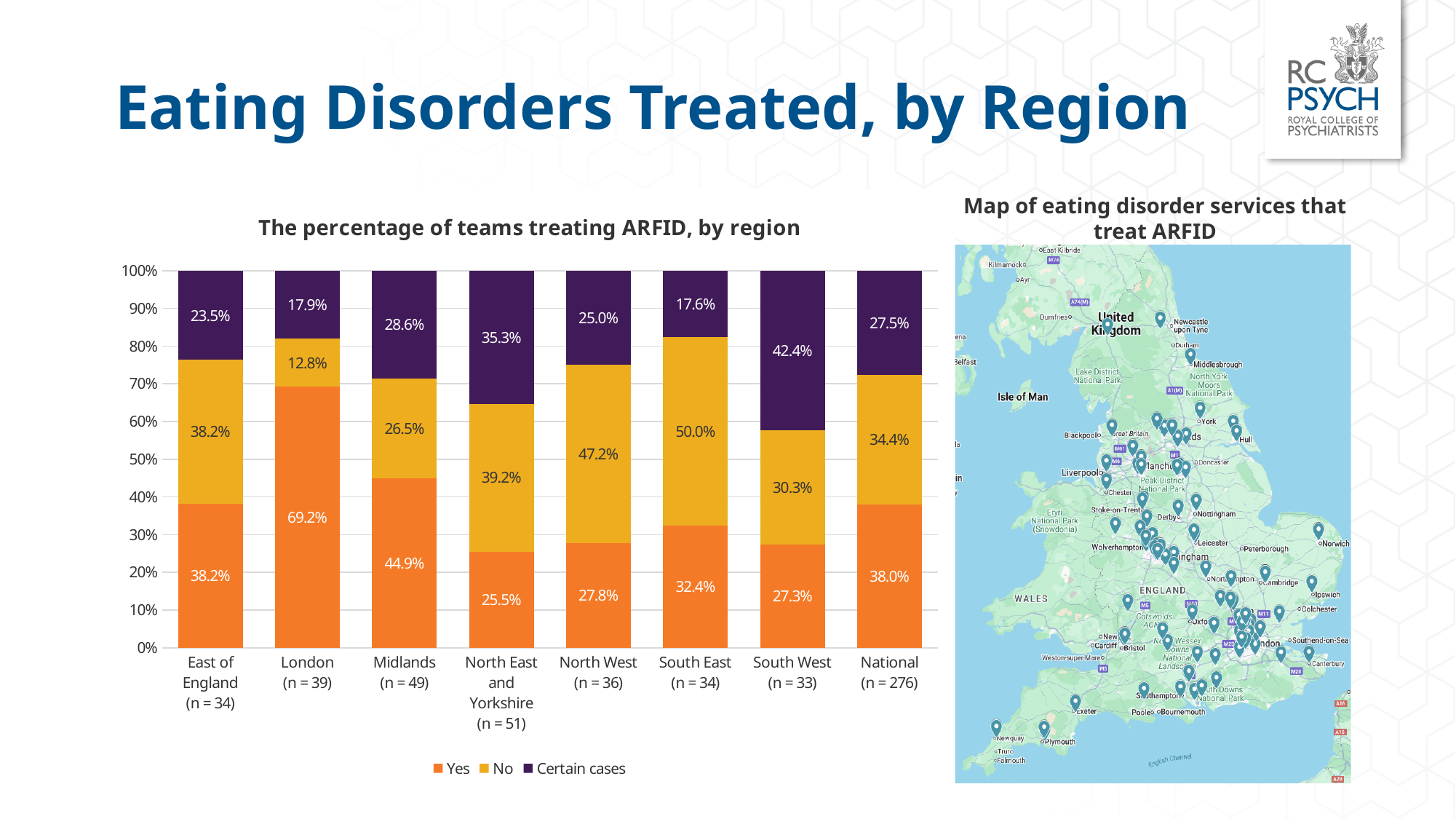
What percentage of teams in London answered Yes to treating ARFID? 69.2% Which region has the lowest 'No' percentage? London How many series does the chart legend list? 3 Which region has the lowest 'Yes' percentage? North East and Yorkshire What is the National 'Yes' percentage? 38.0% Which has a larger 'Yes' percentage, Midlands or National? Midlands Which region has the highest 'Certain cases' percentage? South West How many regions (categories) are shown on the x axis of the chart? 8 What is the 'Certain cases' percentage for the South West? 42.4% Which region has the highest 'Yes' percentage? London What is the 'No' percentage for the North West? 47.2% What is the difference in percentage points between the 'Yes' values for London and North East and Yorkshire? 43.7 percentage points